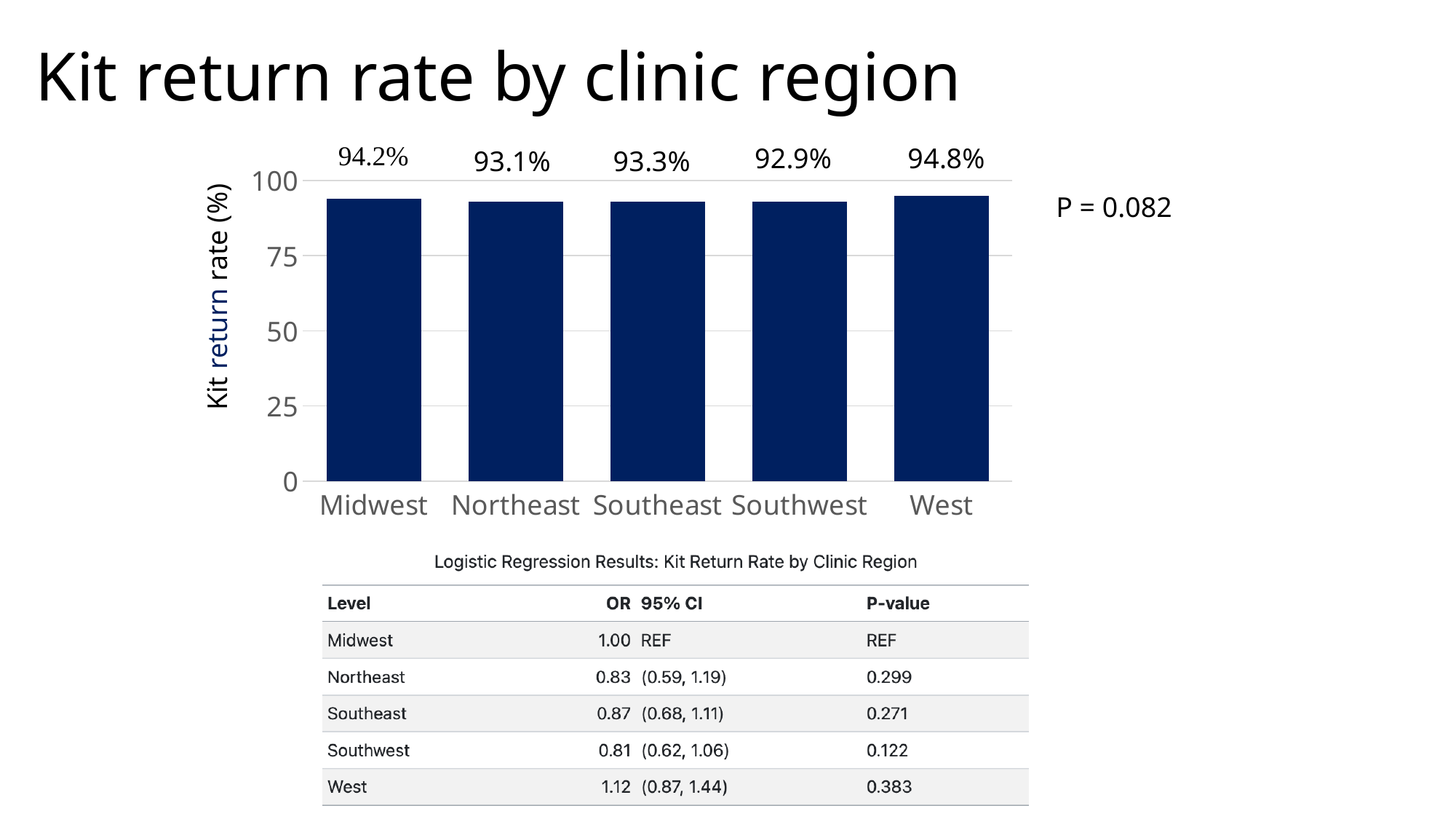
What is the kit return rate for the Midwest region? 94.2% Which region has the highest kit return rate? West What is the kit return rate for the Southeast region? 93.3% What is the P-value shown next to the chart? P = 0.082 Which region has a higher kit return rate, Midwest or Northeast? Midwest What is the kit return rate for the Northeast region? 93.1% What is the kit return rate for the Southwest region? 92.9% Which region has the lowest kit return rate? Southwest What is the kit return rate for the West region? 94.8% What kind of chart is shown on the slide? Bar chart What is the difference in kit return rate between the West and Southwest regions? 1.9% How many regions are shown in the chart? 5